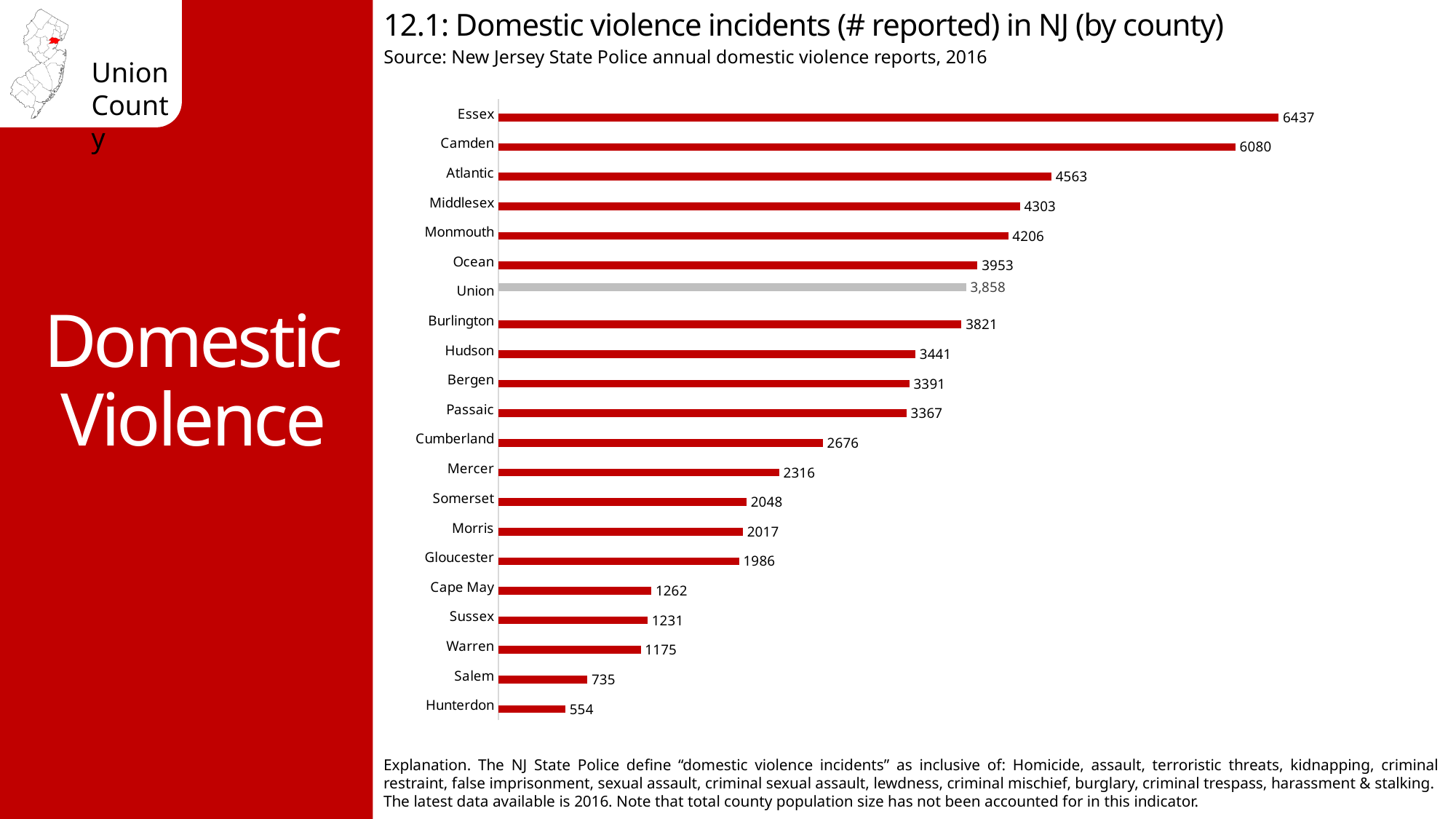
Which county has the lowest number of reported domestic violence incidents? Hunterdon What is the difference between the number of incidents in Union and Burlington? 37 Which county has more reported incidents, Salem or Warren? Warren How many domestic violence incidents were reported in Hunterdon County? 554 Which county's bar is shown in grey rather than red? Union Which county has more reported incidents, Atlantic or Middlesex? Atlantic How many domestic violence incidents were reported in Essex County? 6437 What is the difference between the number of incidents in Essex and Camden? 357 How many counties are shown in the chart? 21 What kind of chart is shown on the slide? Bar chart Which county has the highest number of reported domestic violence incidents? Essex How many domestic violence incidents were reported in Union County? 3,858